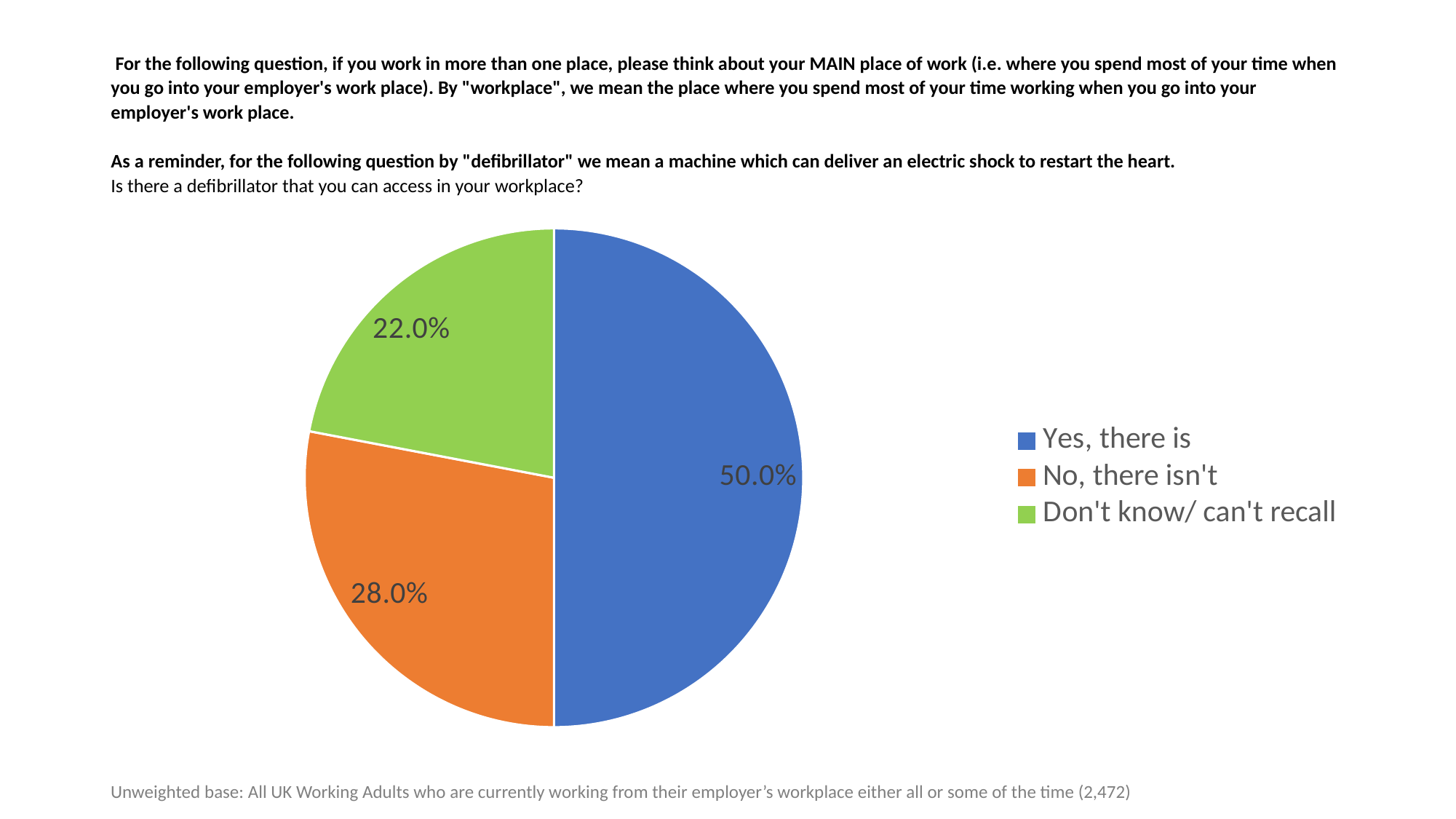
What is the difference in percentage points between "Yes, there is" and "No, there isn't"? 22.0 percentage points How many slices does the pie chart have? 3 What is the difference in percentage points between "No, there isn't" and "Don't know/ can't recall"? 6.0 percentage points What colour is the slice for "Yes, there is"? Blue What percentage of respondents answered "Yes, there is"? 50.0% What is the unweighted base size stated below the chart? 2,472 What kind of chart is shown on the slide? Pie chart Which is larger: the share for "No, there isn't" or the share for "Don't know/ can't recall"? No, there isn't Which response has the largest share of the pie? Yes, there is What percentage of respondents answered "No, there isn't"? 28.0% Which response has the smallest share of the pie? Don't know/ can't recall What percentage of respondents answered "Don't know/ can't recall"? 22.0%